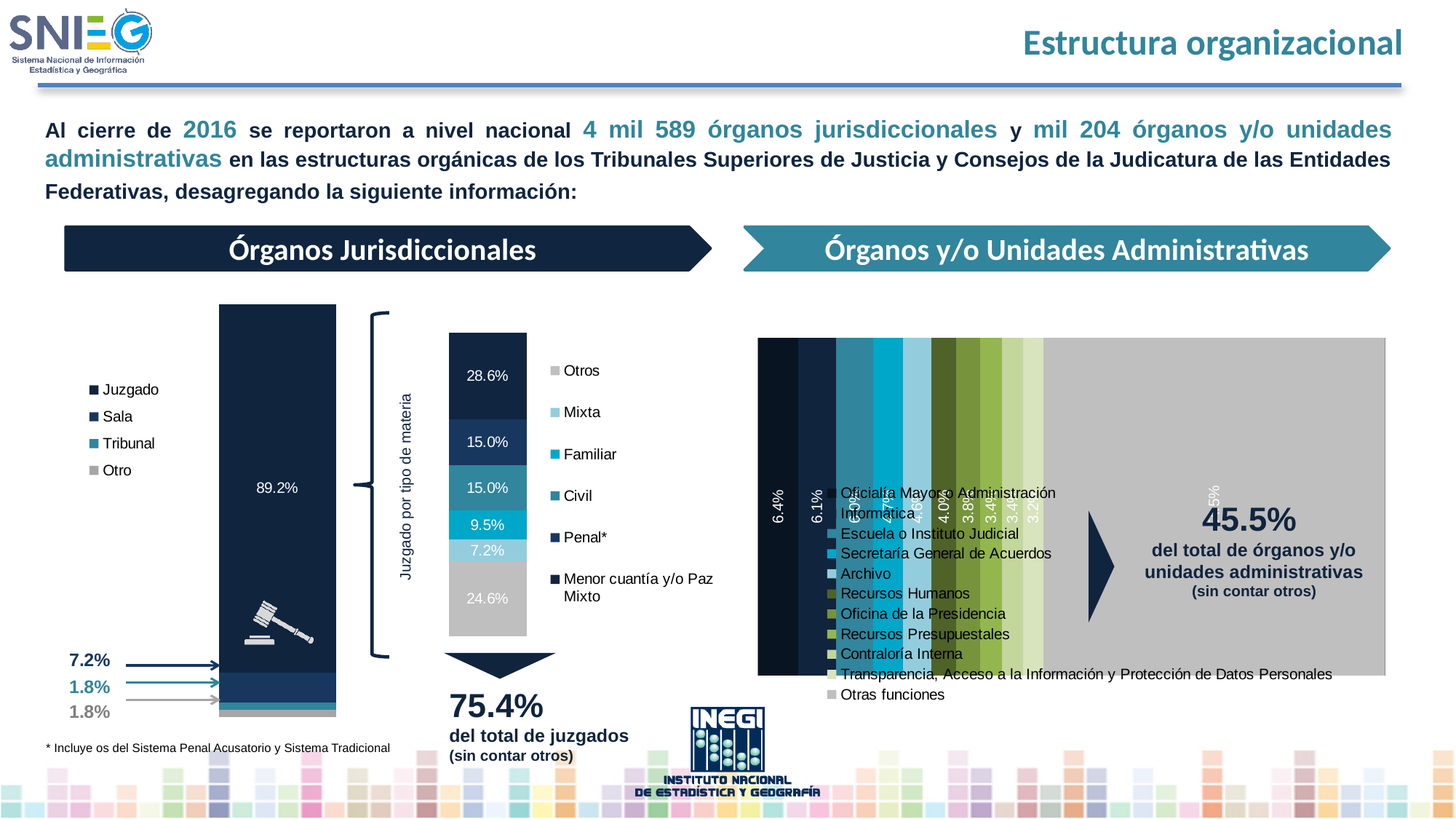
In the Órganos Jurisdiccionales chart on the left, which category has the largest share? Juzgado In the Juzgado por tipo de materia chart in the middle, what percentage is shown for Mixta? 7.2% In the Órganos Jurisdiccionales chart on the left, what is the difference between the Juzgado and Sala percentages? 82.0% In the Órganos Jurisdiccionales chart on the left, how many categories does the legend list? 4 In the Órganos y/o Unidades Administrativas chart on the right, what percentage is shown for Oficialía Mayor o Administración? 6.4% In the Órganos Jurisdiccionales chart on the left, what percentage is shown for Juzgado? 89.2% In the Juzgado por tipo de materia chart in the middle, what percentage is shown for Otros? 24.6% What kind of chart is the Órganos y/o Unidades Administrativas chart on the right? Stacked bar chart In the Juzgado por tipo de materia chart in the middle, which is larger, Familiar or Mixta? Familiar In the Juzgado por tipo de materia chart in the middle, how many categories does the legend list? 6 In the Juzgado por tipo de materia chart in the middle, what percentage is shown for Menor cuantía y/o Paz Mixto? 28.6% In the Órganos Jurisdiccionales chart on the left, what percentage is shown for Sala? 7.2%